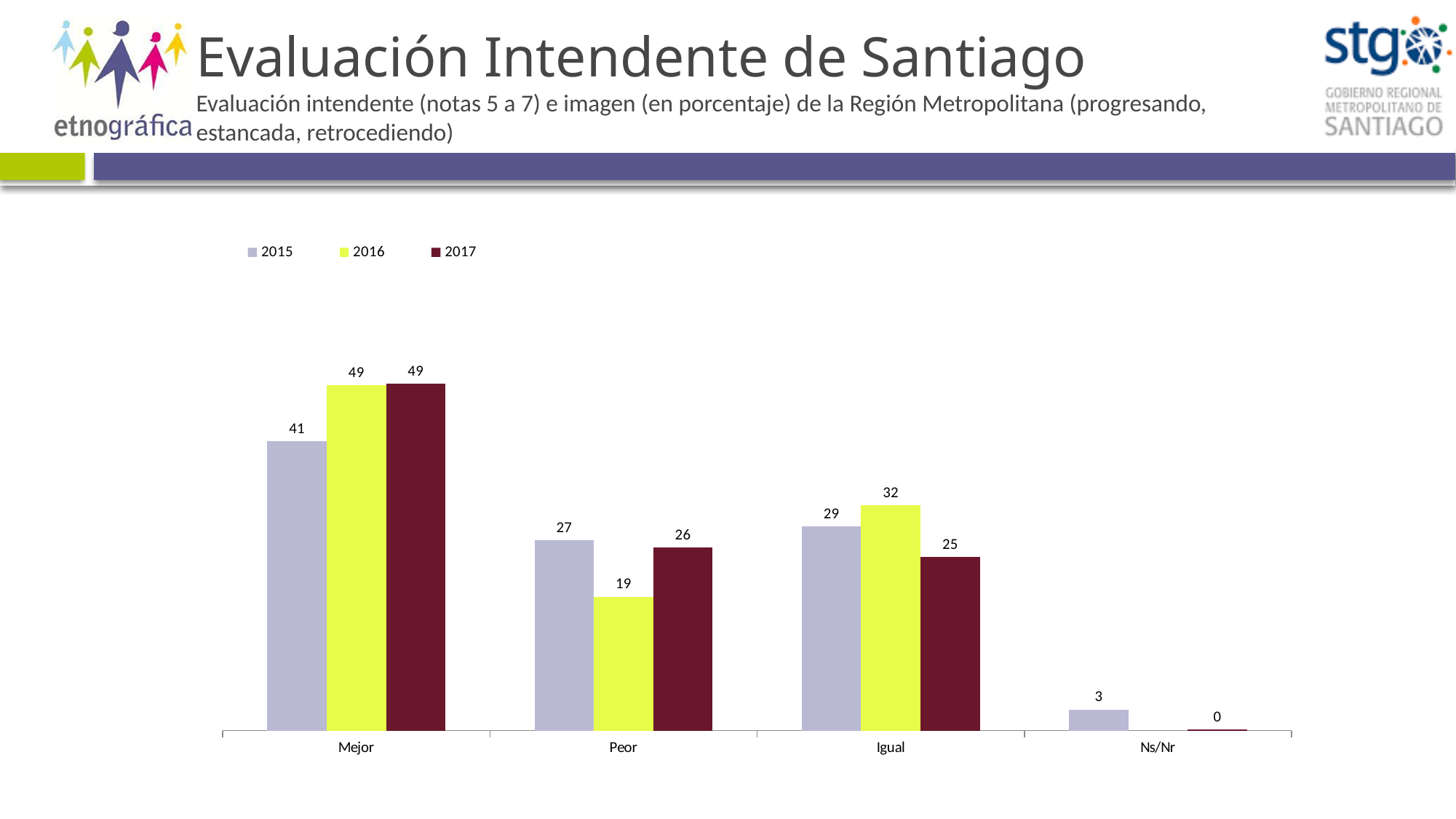
How many series does the legend list? 3 What is the value for 2016 in the Peor category? 19 Which category has the highest value for the 2016 series? Mejor What is the value for 2017 in the Igual category? 25 In the Igual category, which is larger: the 2016 value or the 2017 value? 2016 What is the difference between the 2016 and 2015 values in the Mejor category? 8 What is the value for 2015 in the Mejor category? 41 What is the difference between the 2015 and 2016 values in the Peor category? 8 What kind of chart is shown on the slide? Bar chart How many categories are shown on the x axis? 4 What is the value for 2015 in the Ns/Nr category? 3 Which category has the lowest value for the 2017 series? Ns/Nr